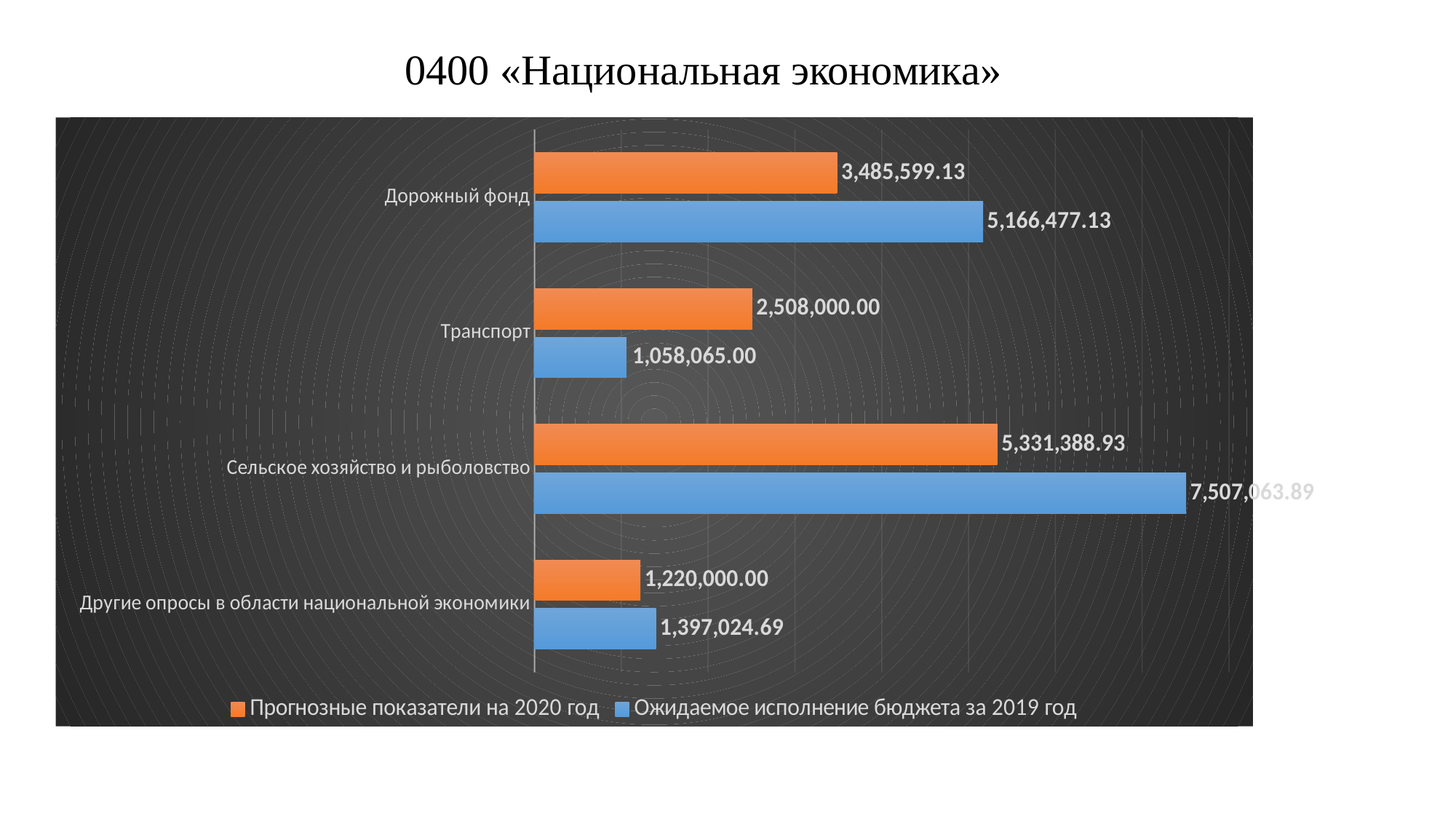
What is the title of the chart? 0400 «Национальная экономика» What is the value of 'Ожидаемое исполнение бюджета за 2019 год' for 'Сельское хозяйство и рыболовство'? 7,507,063.89 What is the difference between 'Ожидаемое исполнение бюджета за 2019 год' and 'Прогнозные показатели на 2020 год' for 'Дорожный фонд'? 1,680,878.00 What is the value of 'Прогнозные показатели на 2020 год' for 'Другие опросы в области национальной экономики'? 1,220,000.00 What is the value of 'Ожидаемое исполнение бюджета за 2019 год' for 'Транспорт'? 1,058,065.00 What is the value of 'Прогнозные показатели на 2020 год' for 'Дорожный фонд'? 3,485,599.13 How many series does the legend list? 2 What type of chart is shown on the slide? Bar chart How many categories are shown on the chart? 4 For 'Транспорт', which is larger: 'Прогнозные показатели на 2020 год' or 'Ожидаемое исполнение бюджета за 2019 год'? Прогнозные показатели на 2020 год Which category has the highest value for 'Прогнозные показатели на 2020 год'? Сельское хозяйство и рыболовство Which category has the lowest value for 'Ожидаемое исполнение бюджета за 2019 год'? Транспорт